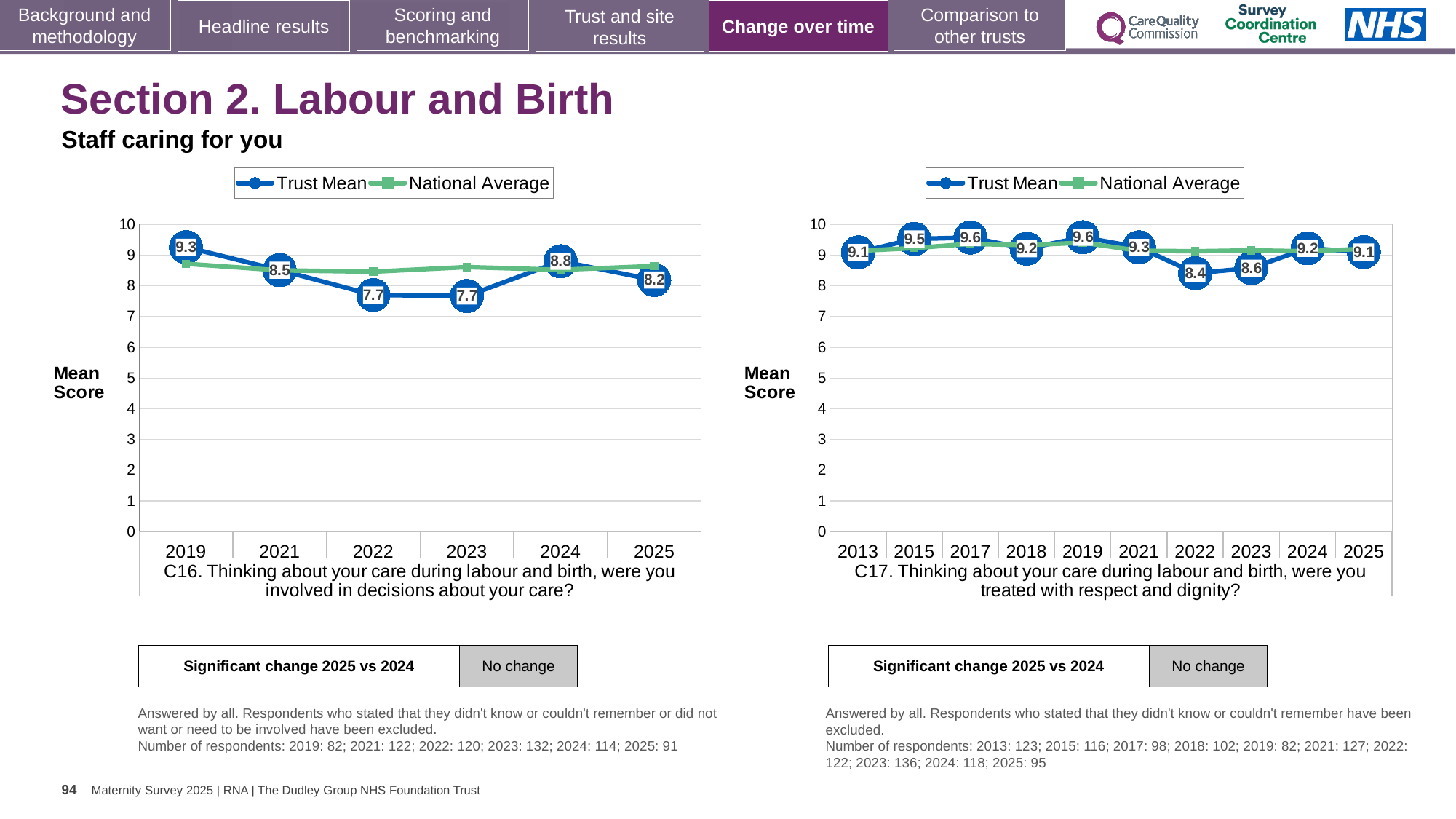
In the C16 chart (left), what is the difference between the Trust Mean scores for 2019 and 2025? 1.1 In the C16 chart (left), what is the Trust Mean score for 2025? 8.2 In the C16 chart (left), what is the Trust Mean score for 2019? 9.3 In the C17 chart (right), which is larger, the Trust Mean score for 2015 or for 2023? 2015 What type of chart is the C17 chart (right)? Line chart In the C17 chart (right), how many series does the legend list? 2 In the C17 chart (right), what is the difference between the Trust Mean scores for 2025 and 2022? 0.7 In the C17 chart (right), what is the Trust Mean score for 2022? 8.4 In the C16 chart (left), how many years are shown on the x axis? 6 In the C16 chart (left), which year has the highest Trust Mean score? 2019 In the C16 chart (left), is the National Average value for 2019 greater or less than 8? greater In the C17 chart (right), which year has the lowest Trust Mean score? 2022